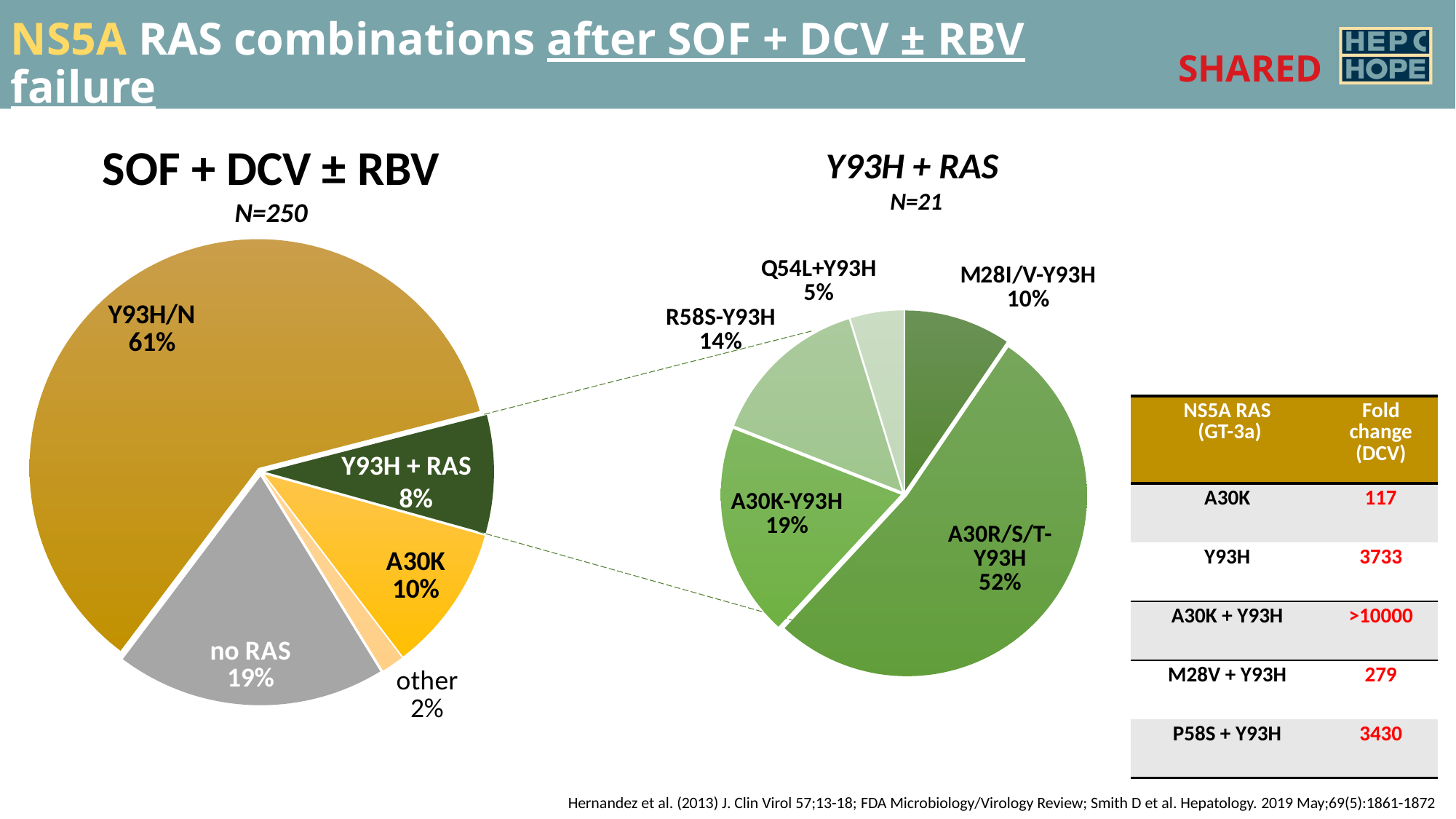
In the Y93H + RAS pie chart, which is larger, A30K-Y93H or M28I/V-Y93H? A30K-Y93H In the SOF + DCV ± RBV pie chart, what share is labelled for no RAS? 19% In the SOF + DCV ± RBV pie chart, which slice is the smallest? other In the SOF + DCV ± RBV pie chart, which slice is the largest? Y93H/N In the Y93H + RAS pie chart, what share is labelled for R58S-Y93H? 14% In the SOF + DCV ± RBV pie chart, how many slices are there? 5 What is the N value shown under the Y93H + RAS pie chart title? N=21 In the SOF + DCV ± RBV pie chart, what is the difference in percentage points between A30K and Y93H + RAS? 2 In the Y93H + RAS pie chart, which slice is the smallest? Q54L+Y93H In the SOF + DCV ± RBV pie chart, what share is labelled for Y93H/N? 61% What type of chart is used for SOF + DCV ± RBV? Pie chart In the Y93H + RAS pie chart, what share is labelled for A30R/S/T-Y93H? 52%